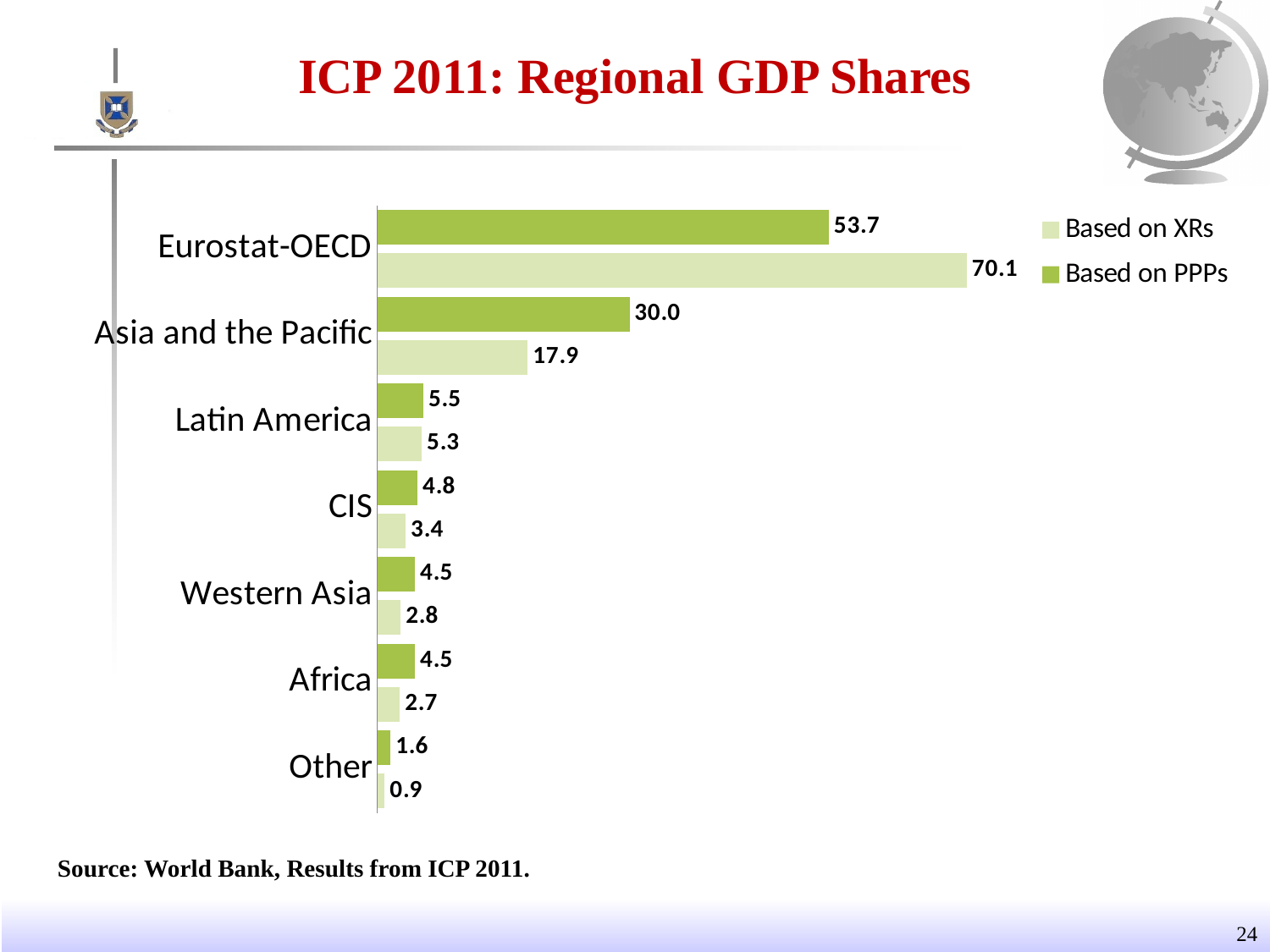
Which region has the highest value based on XRs? Eurostat-OECD What is the value for Eurostat-OECD based on PPPs? 53.7 What is the difference between the PPP-based and XR-based values for Asia and the Pacific? 12.1 What is the difference between the XR-based and PPP-based values for Eurostat-OECD? 16.4 Which region has the lowest value based on PPPs? Other What is the title of the chart? ICP 2011: Regional GDP Shares For Western Asia, which is larger: the value based on PPPs or the value based on XRs? Based on PPPs What kind of chart is shown on the slide? Bar chart What is the value for CIS based on PPPs? 4.8 How many regions are shown on the chart? 7 What is the value for Asia and the Pacific based on XRs? 17.9 How many series does the legend list? 2